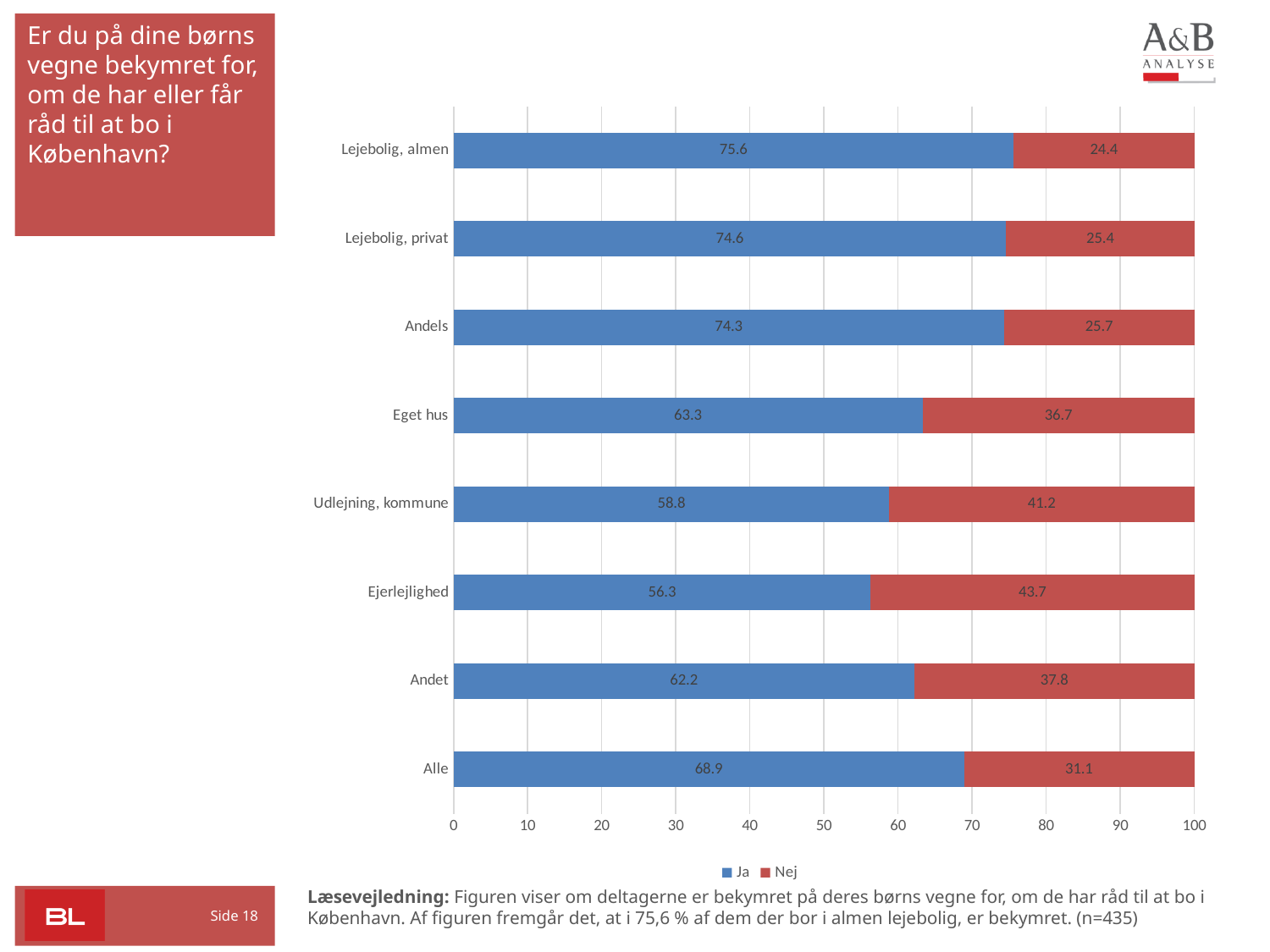
What is the "Ja" value for Lejebolig, almen? 75.6 What kind of chart is shown on the slide? Stacked bar chart How many series does the legend list? 2 What is the "Ja" value for Alle? 68.9 Which category has the lowest "Ja" value? Ejerlejlighed What is the "Nej" value for Ejerlejlighed? 43.7 How many categories are shown on the chart? 8 Which category has the highest "Ja" value? Lejebolig, almen Which colour represents the "Nej" series? Red Which is larger, the "Nej" value for Andet or the "Nej" value for Eget hus? Andet What is the difference between the "Ja" values for Eget hus and Udlejning, kommune? 4.5 What is the total of the stacked bar for Andels? 100